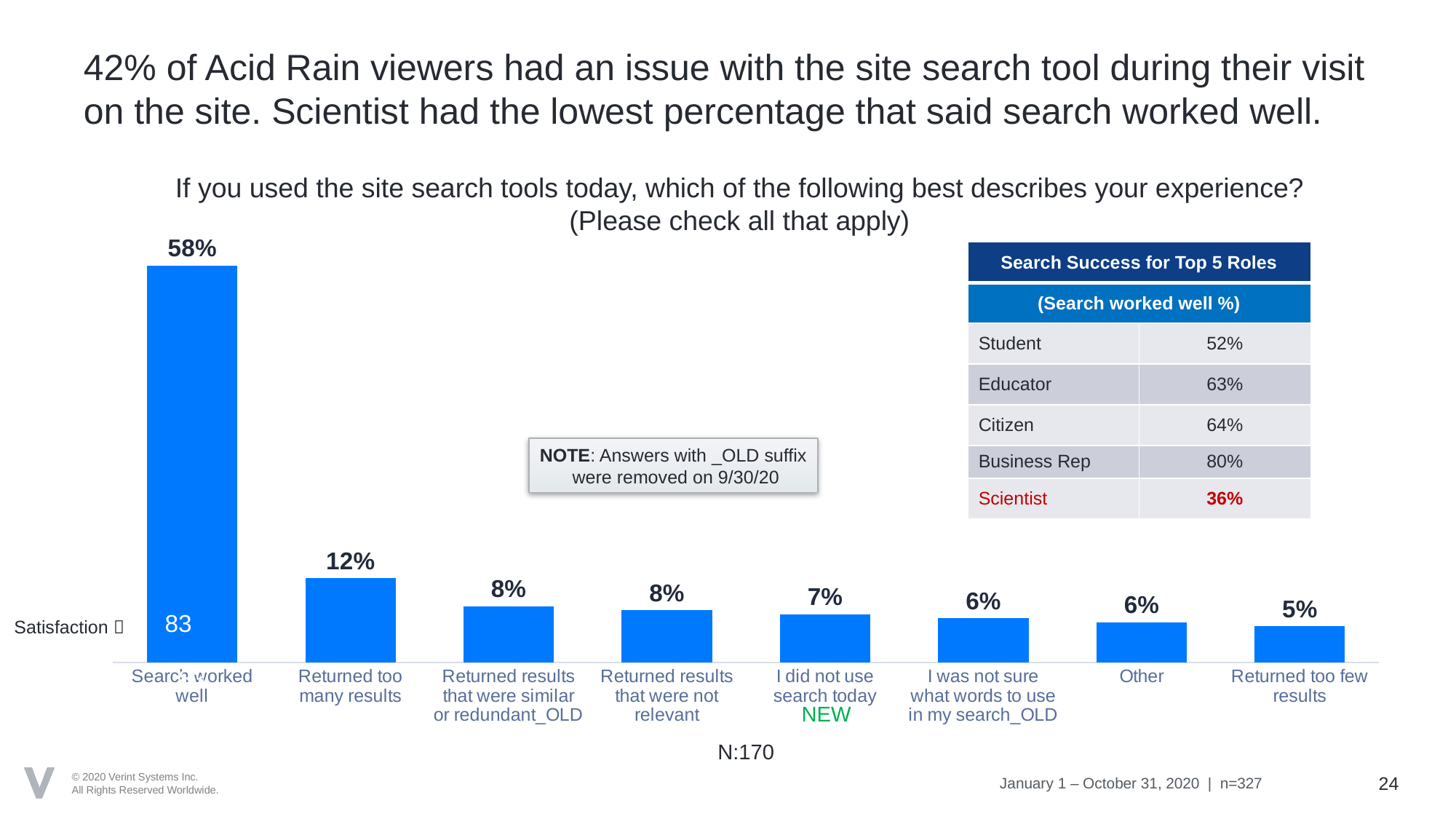
What percentage of respondents said "Search worked well"? 58% What is the difference between "Search worked well" and "Returned too many results"? 46% What is the value for "Returned too few results"? 5% Which category has the lowest value in the bar chart? Returned too few results Which is larger: "Returned too many results" or "Returned results that were not relevant"? Returned too many results Which category has the highest value in the bar chart? Search worked well How many categories are shown in the bar chart? 8 What kind of chart is shown on the slide? Bar chart Do the values in the bar chart rise or fall from left to right? Fall What is the value for "Returned too many results"? 12% What is the value for "I did not use search today"? 7% What is the value for "Other"? 6%